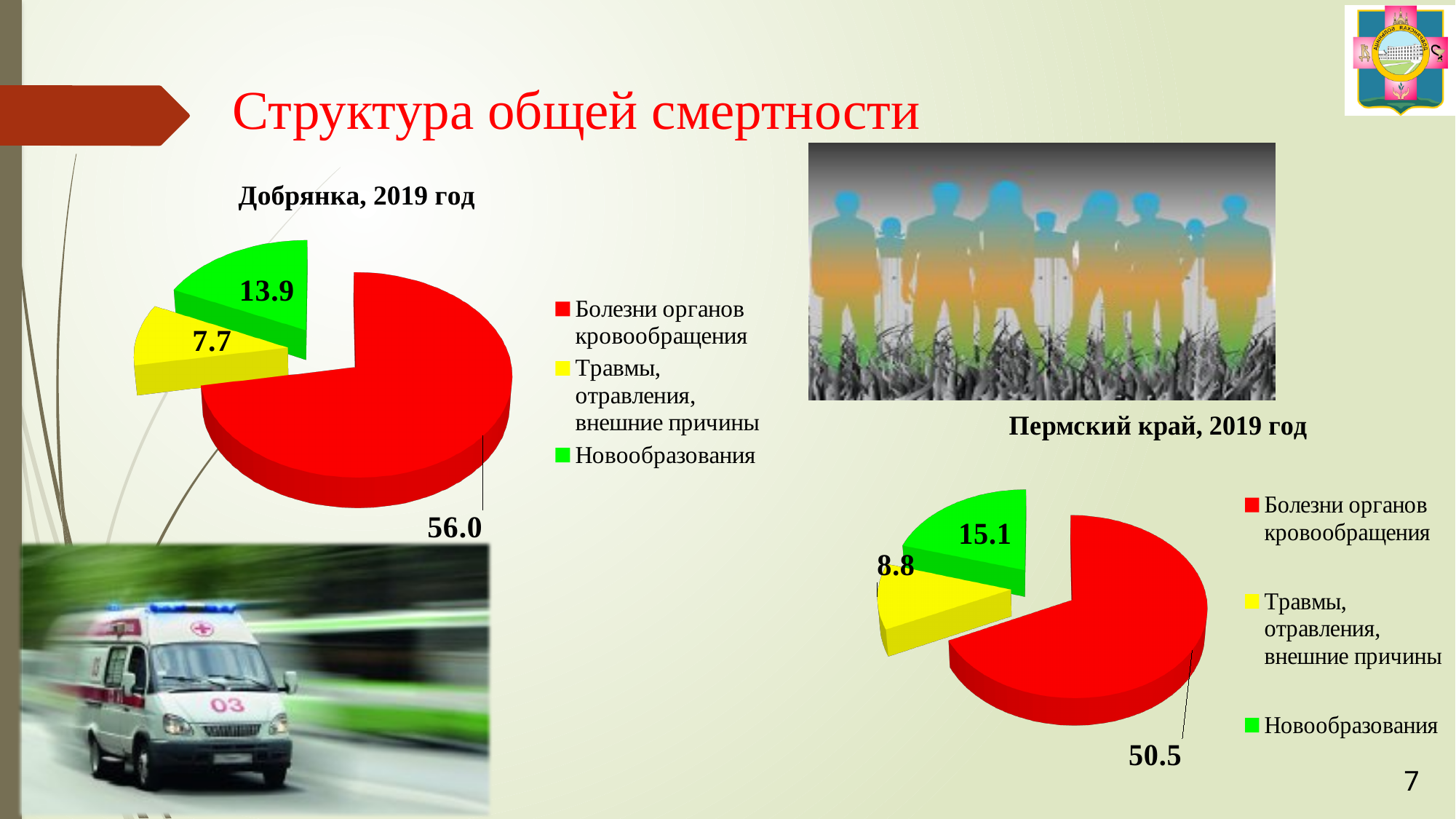
What type of chart is the one titled "Пермский край, 2019 год"? Pie chart In the chart titled "Пермский край, 2019 год", what is the difference between the values for Болезни органов кровообращения and Новообразования? 35.4 In the chart titled "Добрянка, 2019 год", what is the difference between the values for Новообразования and Травмы, отравления, внешние причины? 6.2 Which chart shows a larger value for Новообразования: "Добрянка, 2019 год" or "Пермский край, 2019 год"? Пермский край, 2019 год In the chart titled "Добрянка, 2019 год", which colour represents Травмы, отравления, внешние причины? Yellow In the chart titled "Пермский край, 2019 год", what is the value for Травмы, отравления, внешние причины? 8.8 In the chart titled "Пермский край, 2019 год", which category has the largest value? Болезни органов кровообращения In the chart titled "Добрянка, 2019 год", what is the value for Болезни органов кровообращения? 56.0 In the chart titled "Добрянка, 2019 год", what is the value for Новообразования? 13.9 In the chart titled "Добрянка, 2019 год", which category has the smallest value? Травмы, отравления, внешние причины How many slices does the chart titled "Добрянка, 2019 год" have? 3 In the chart titled "Пермский край, 2019 год", what is the value for Болезни органов кровообращения? 50.5